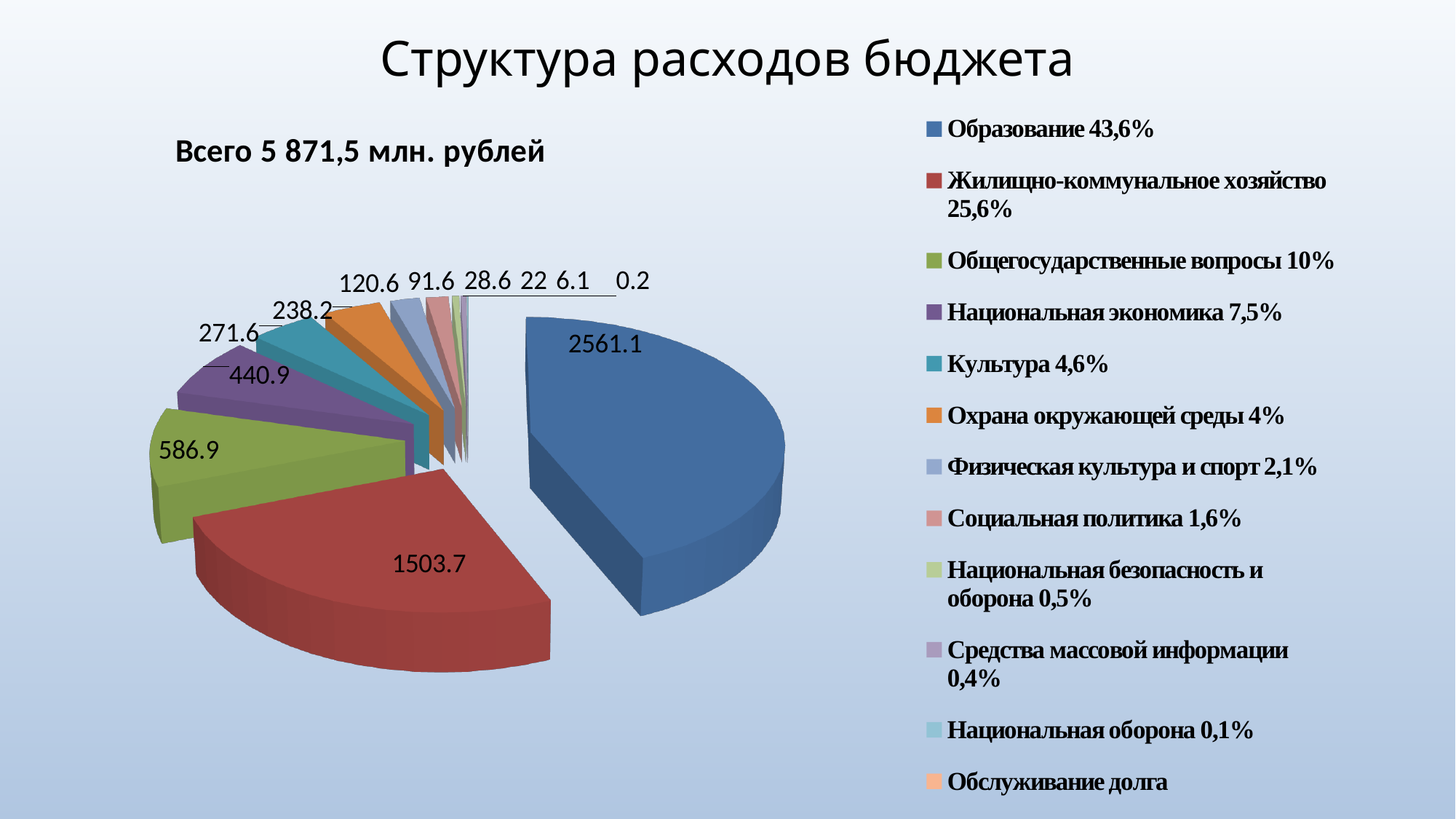
What is the difference between the values for Образование and Жилищно-коммунальное хозяйство? 1057.4 What is the value shown for Общегосударственные вопросы? 586.9 What is the value shown for Образование? 2561.1 Which is larger, the value for Национальная экономика or the value for Охрана окружающей среды? Национальная экономика How many categories does the pie chart have? 12 Which category has the largest slice of the pie? Образование What type of chart is shown on the slide? pie chart What total amount is stated above the chart? Всего 5 871,5 млн. рублей What is the value shown for Культура? 271.6 What is the value shown for Жилищно-коммунальное хозяйство? 1503.7 Which category has the smallest slice of the pie? Обслуживание долга What share of the pie does Жилищно-коммунальное хозяйство represent according to the legend? 25,6%